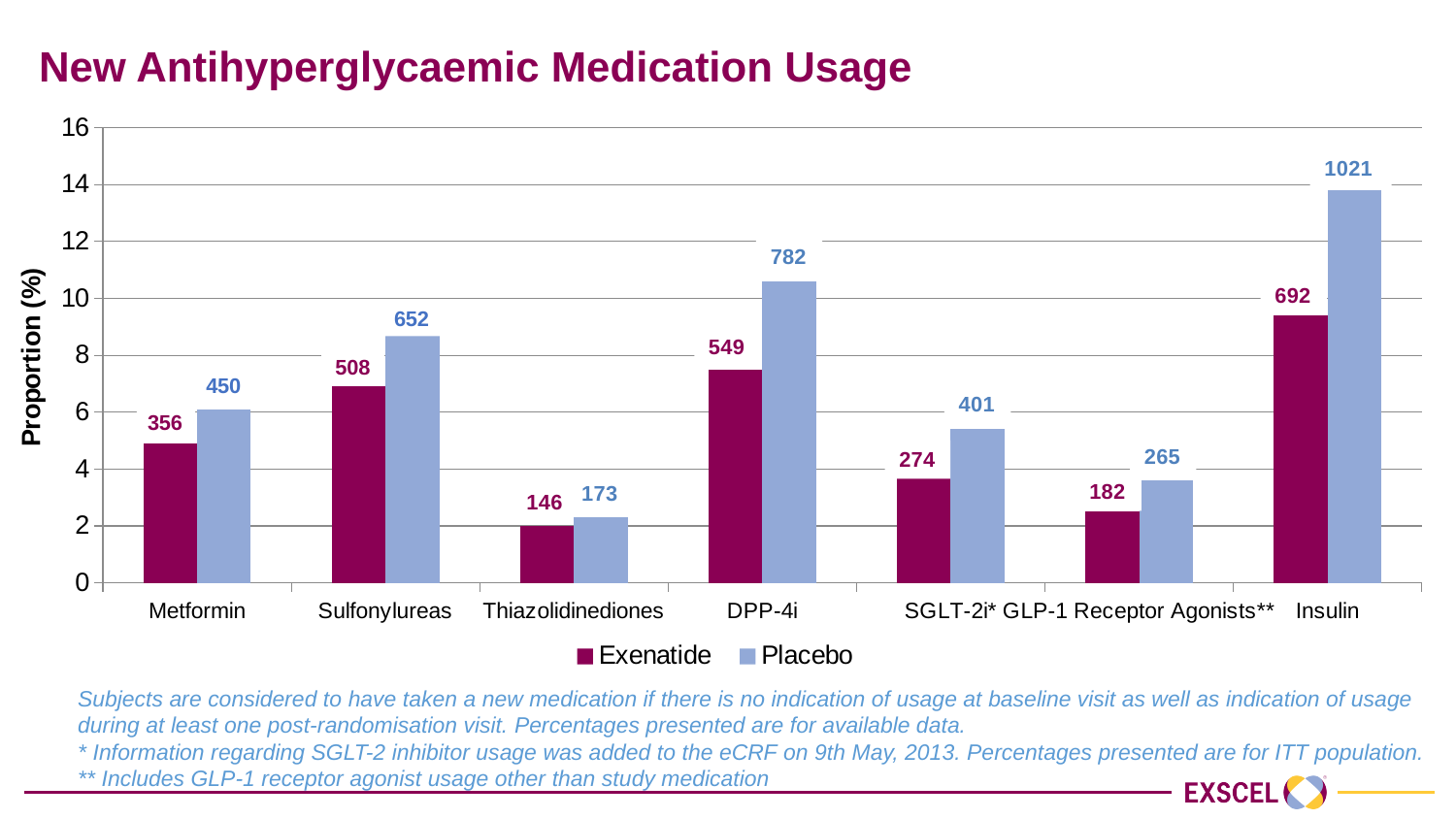
What is the label of the y axis? Proportion (%) Which category has the shortest Exenatide bar? Thiazolidinediones What kind of chart is shown on the slide? bar chart What number is printed above the Exenatide bar for Metformin? 356 How many series does the legend list? 2 Is the Placebo proportion for Insulin greater or less than 12? greater What number is printed above the Placebo bar for Insulin? 1021 What is the difference between the numbers printed above the Placebo and Exenatide bars for Sulfonylureas? 144 For DPP-4i, which series has the higher proportion, Exenatide or Placebo? Placebo What number is printed above the Placebo bar for DPP-4i? 782 Which category has the tallest bar in the chart? Insulin How many medication categories are shown on the x axis? 7